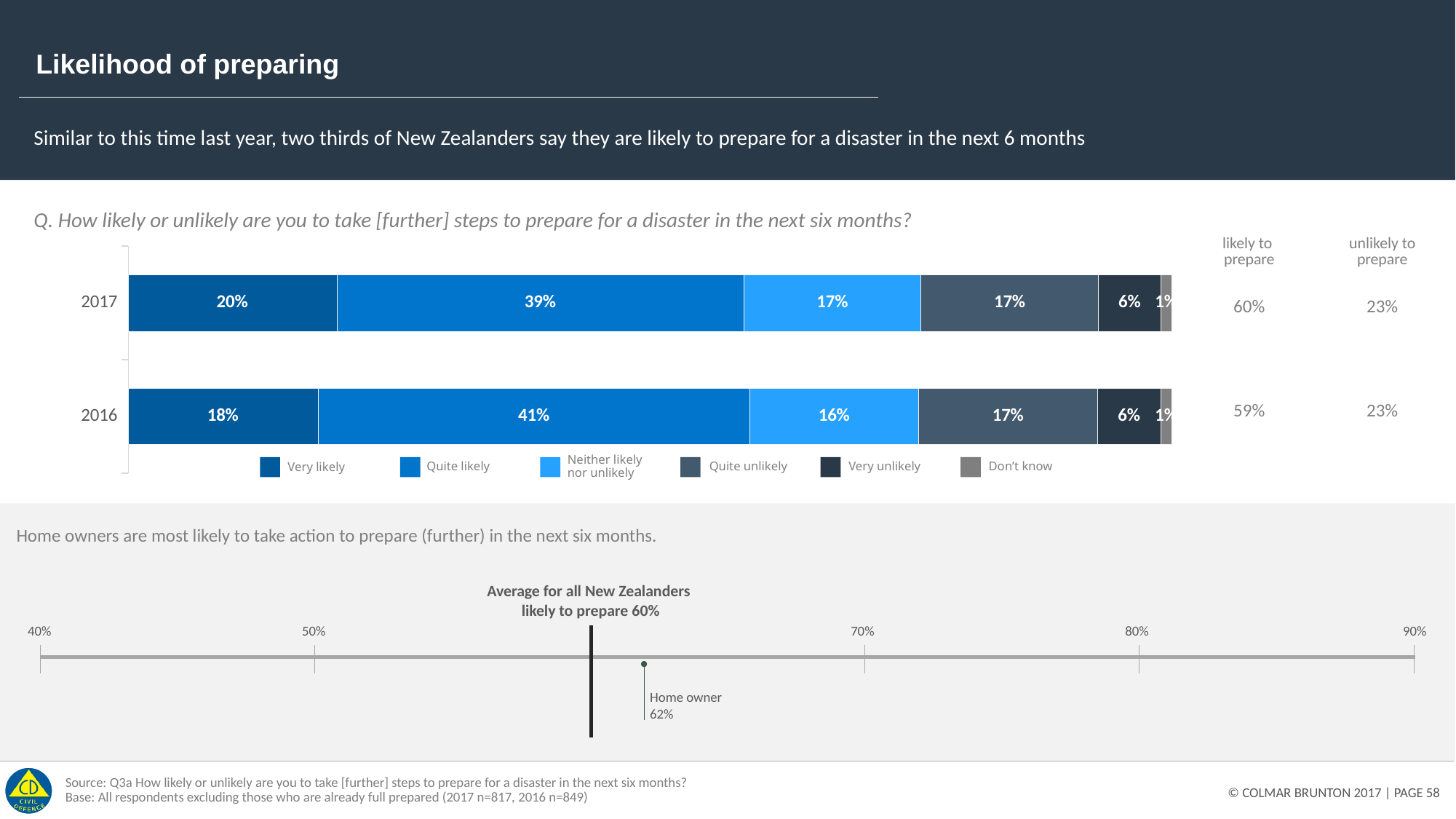
In the stacked bar chart, is the 'Very likely' share larger in 2017 or in 2016? 2017 In the stacked bar chart, what is the difference between the 'Quite likely' share in 2016 and in 2017? 2 percentage points In the stacked bar chart, what percentage of respondents in 2016 said they were 'Quite likely' to prepare? 41% In the stacked bar chart, what percentage of respondents in 2017 said they were 'Very likely' to prepare? 20% How many years are shown in the stacked bar chart? 2 In the stacked bar chart, which response category has the largest share in 2017? Quite likely How many series does the legend of the stacked bar chart list? 6 In the stacked bar chart, what percentage of respondents in 2016 were 'Very unlikely' to prepare? 6% What type of chart is used to show the likelihood responses for 2017 and 2016? Stacked bar chart In the stacked bar chart, what percentage of respondents in 2017 were 'Neither likely nor unlikely'? 17% In the stacked bar chart, which response category has the smallest share in 2016? Don't know In the lower chart, what is the 'likely to prepare' percentage for Home owners? 62%